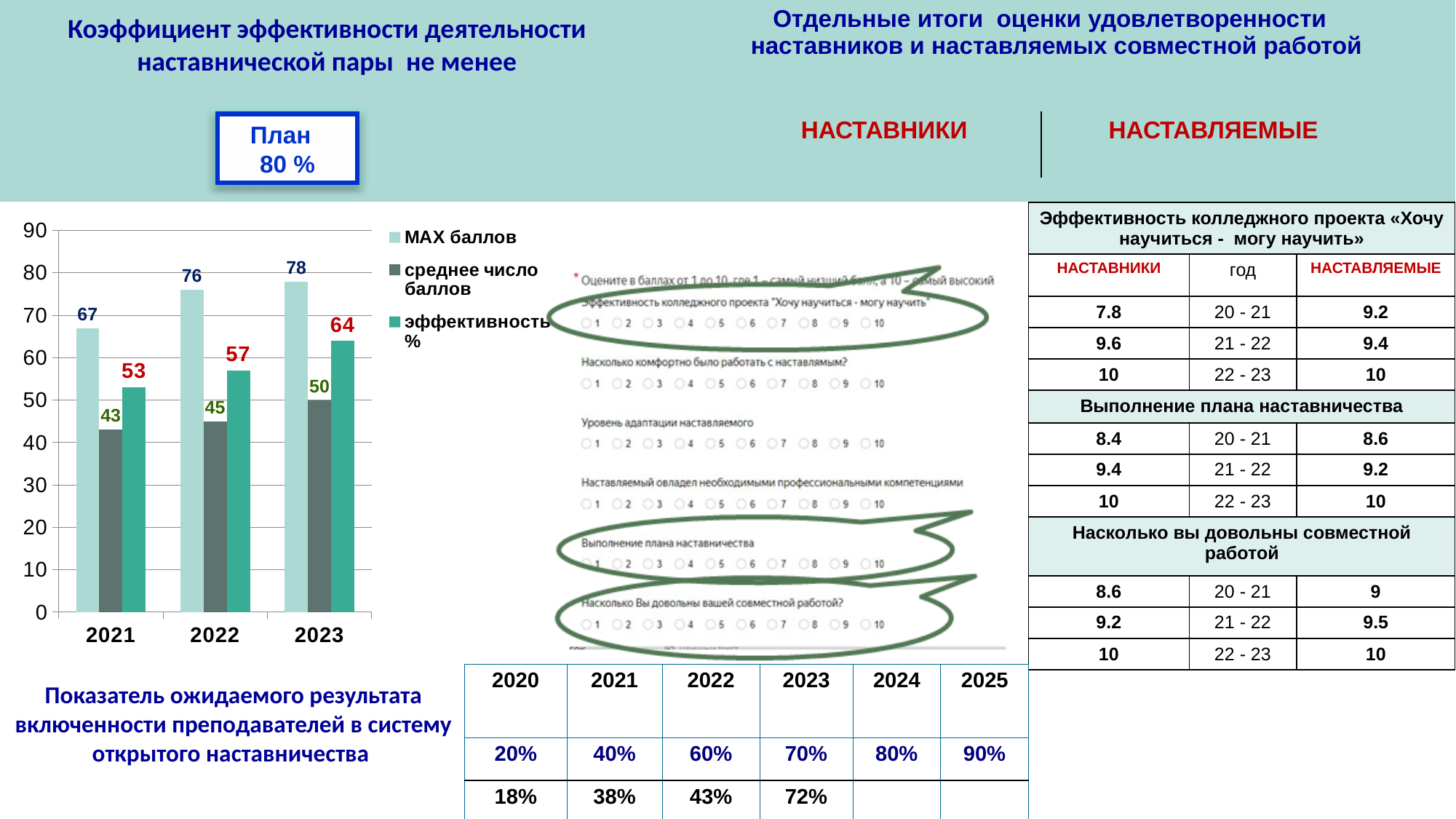
How many years are shown on the x axis of the bar chart? 3 What is the value of "среднее число баллов" for 2022? 45 What is the difference between "MAX баллов" and "среднее число баллов" in 2023? 28 What is the value of "MAX баллов" for 2021? 67 What is the value of "эффективность %" for 2023? 64 Which is larger: "эффективность %" in 2022 or "среднее число баллов" in 2023? эффективность % in 2022 How many series does the chart legend list? 3 Does "MAX баллов" rise or fall from 2021 to 2023? rise In which year is "эффективность %" highest? 2023 What type of chart is shown on the left of the slide? bar chart In which year is "среднее число баллов" lowest? 2021 Which series in the chart is shown in dark grey? среднее число баллов